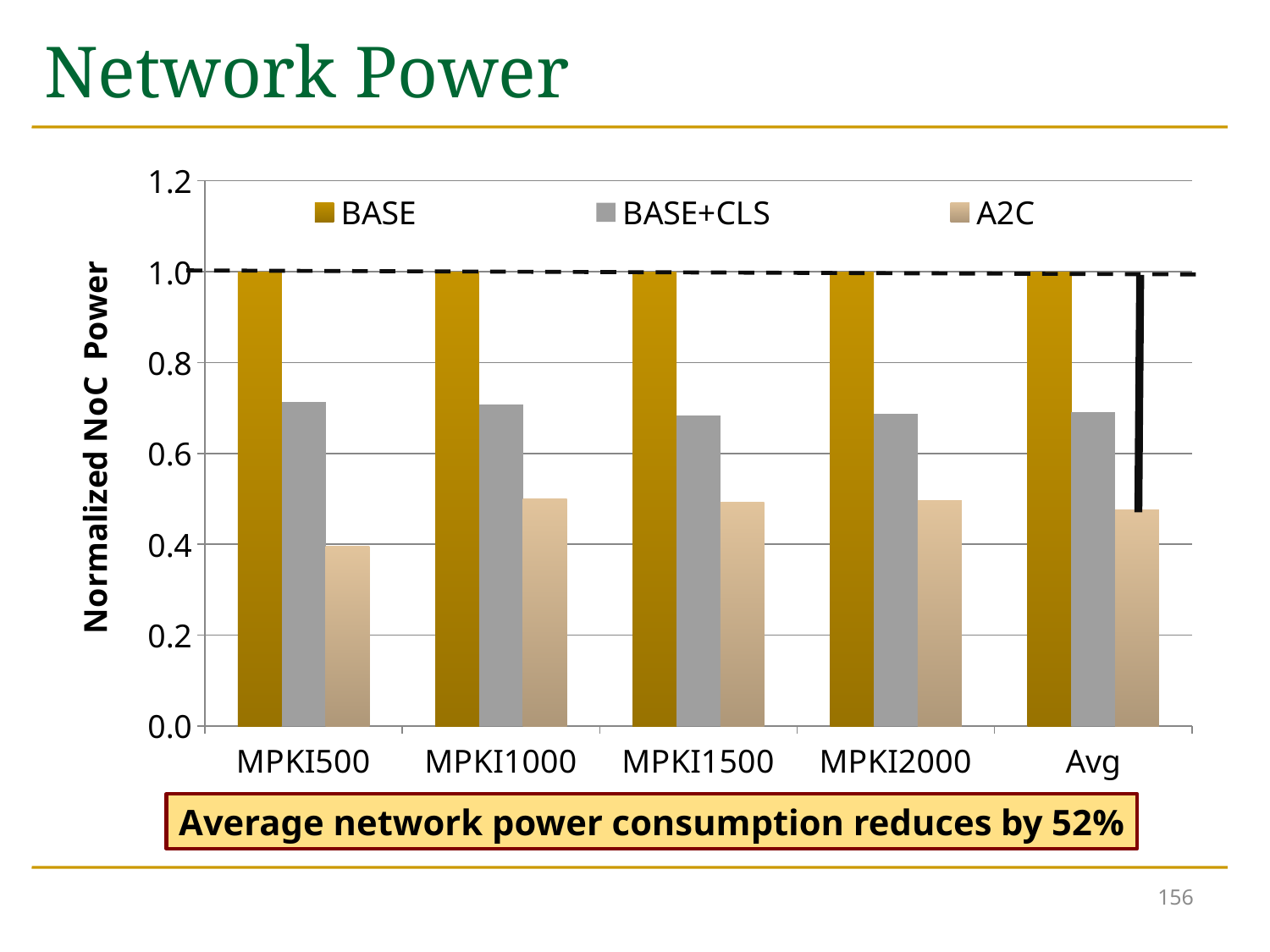
Is the value of A2C for MPKI1000 greater or less than 0.6? less Is the value of BASE+CLS for Avg greater or less than 0.8? less What is the title of the y axis? Normalized NoC Power What kind of chart is shown on the slide? bar chart How many series does the legend list? 3 What is the value of BASE for Avg? 1.0 Is the value of A2C for MPKI500 greater or less than 0.6? less For MPKI1500, which is larger: BASE+CLS or A2C? BASE+CLS How many categories are shown on the x axis? 5 For which category is the A2C value lowest? MPKI500 What is the value of BASE for MPKI500? 1.0